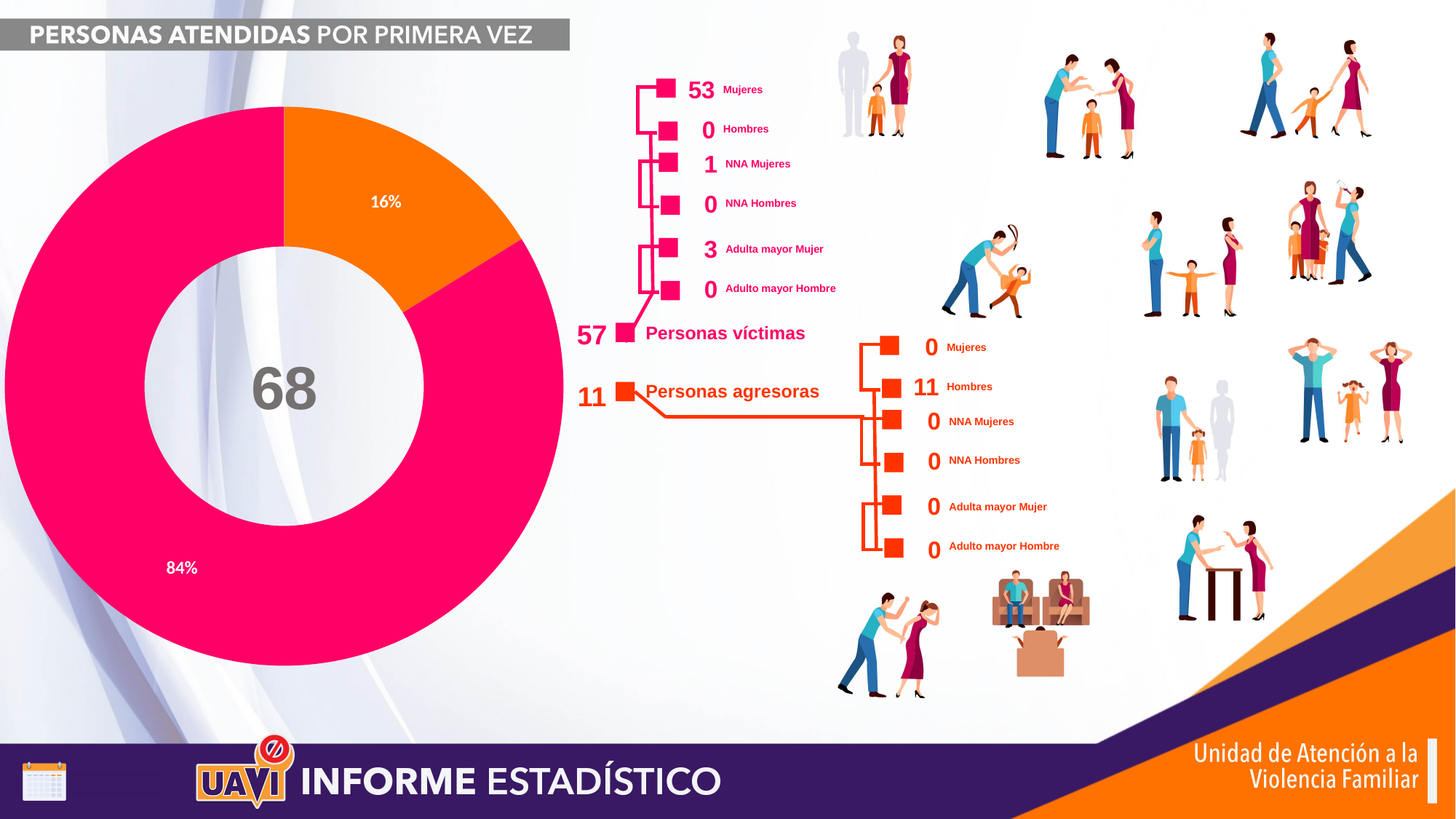
What is the value shown for Personas víctimas? 57 What is the difference in percentage points between the 84% slice and the 16% slice of the donut chart? 68 How many slices does the donut chart have? 2 What is the value shown for Personas agresoras? 11 What percentage is shown on the orange slice of the donut chart? 16% What number is printed in the centre of the donut chart? 68 Which slice of the donut chart is larger, the pink one or the orange one? Pink What is the title shown at the top left of the slide above the donut chart? PERSONAS ATENDIDAS POR PRIMERA VEZ Which colour is used for the Personas agresoras group in the donut chart? Orange What percentage is shown on the pink slice of the donut chart? 84% What kind of chart is shown on the left of the slide? Pie chart (donut) What is the combined total of Personas víctimas (57) and Personas agresoras (11)? 68